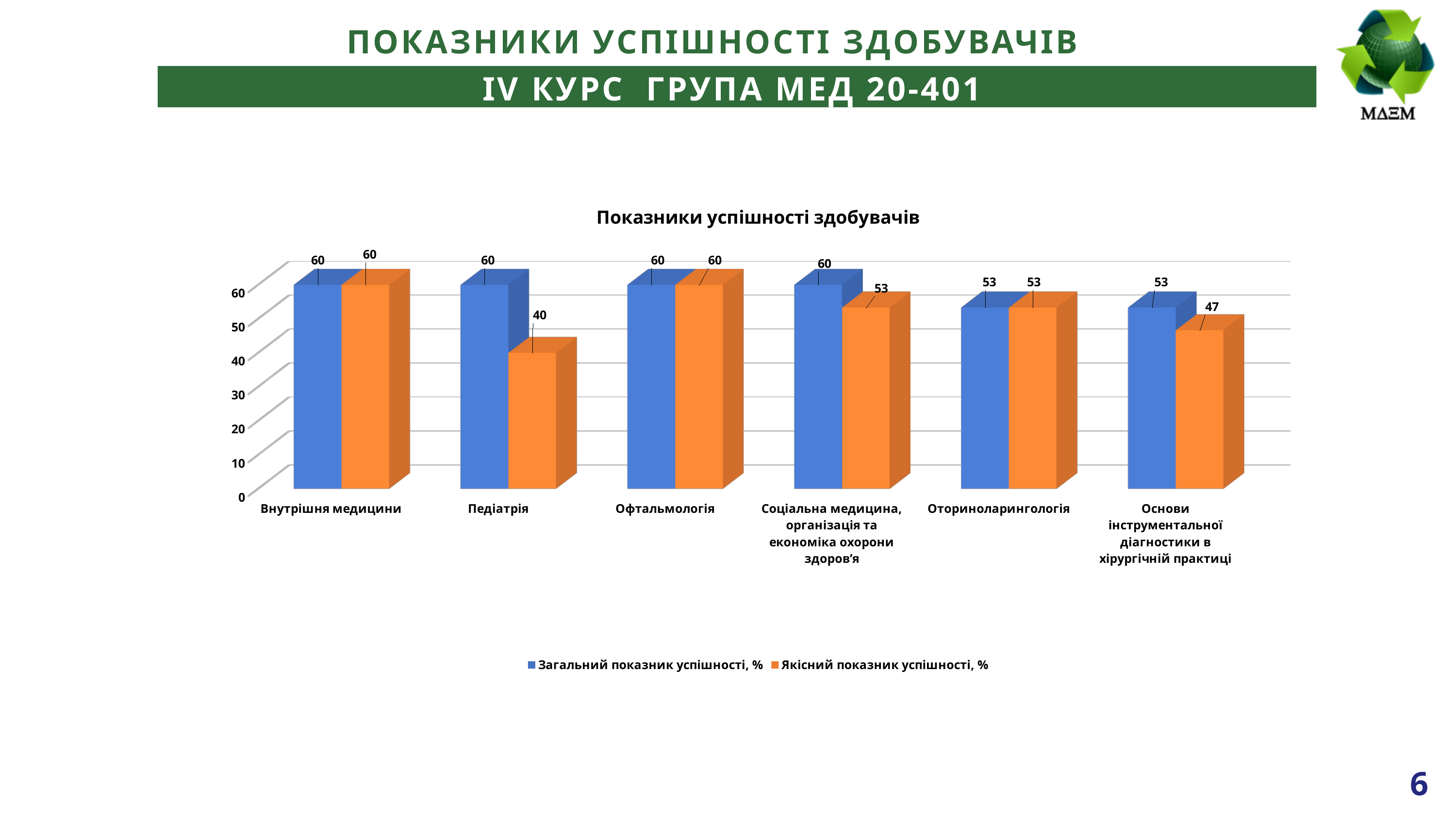
What is the value of Якісний показник успішності, % for Соціальна медицина, організація та економіка охорони здоров’я? 53 What is the title of the chart? Показники успішності здобувачів What is the value of Якісний показник успішності, % for Основи інструментальної діагностики в хірургічній практиці? 47 What is the value of Якісний показник успішності, % for Педіатрія? 40 What is the difference between Загальний показник успішності, % and Якісний показник успішності, % for Основи інструментальної діагностики в хірургічній практиці? 6 How many series does the legend list? 2 What is the difference between Загальний показник успішності, % and Якісний показник успішності, % for Педіатрія? 20 How many categories are shown on the x axis? 6 What kind of chart is shown on the slide? Bar chart Which is larger: Якісний показник успішності, % for Офтальмологія or for Оториноларингологія? Офтальмологія What is the value of Загальний показник успішності, % for Педіатрія? 60 Which category has the lowest value of Якісний показник успішності, %? Педіатрія